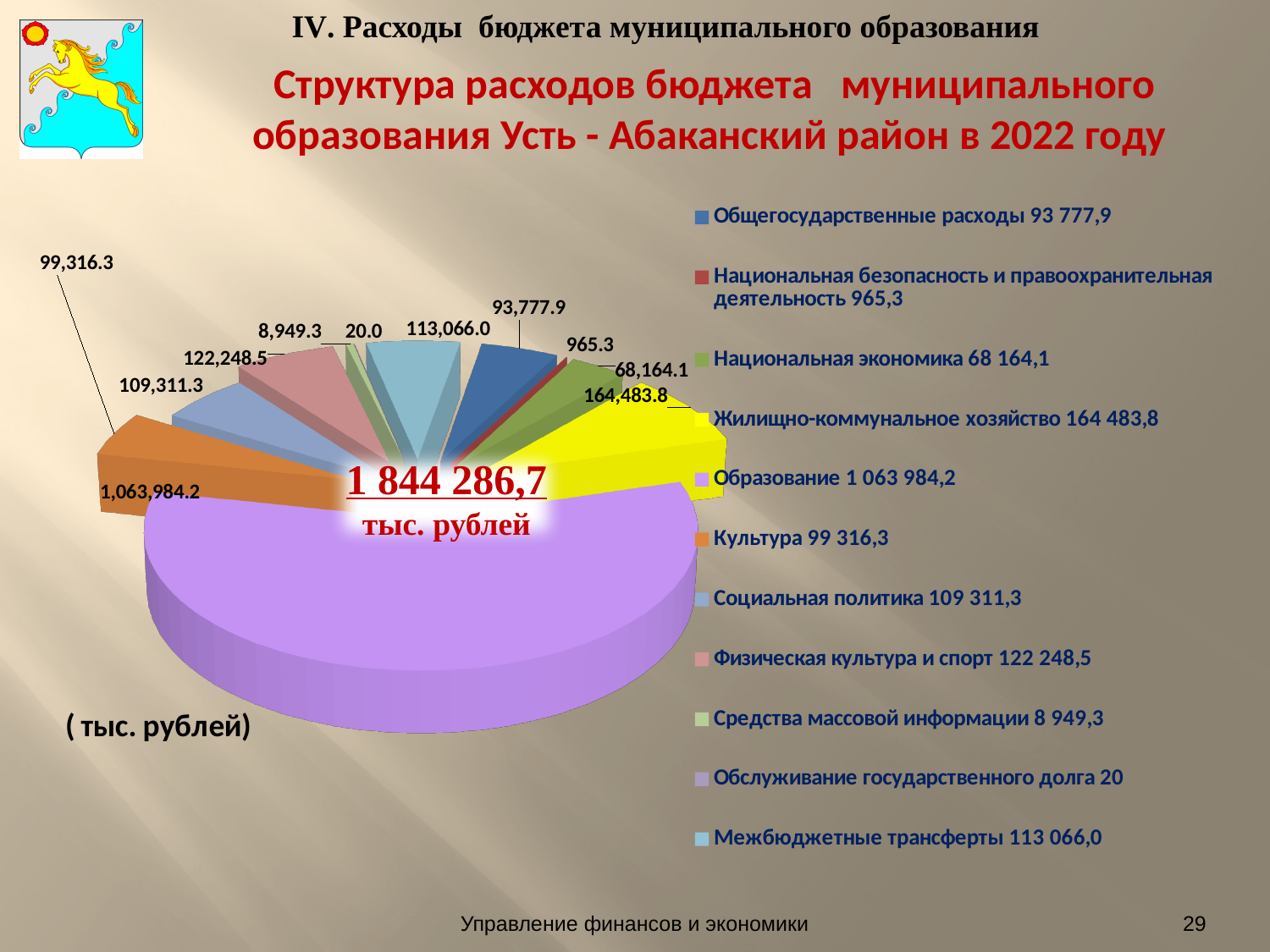
What unit is stated below the pie chart? тыс. рублей What is the value for Жилищно-коммунальное хозяйство? 164,483.8 What is the value for Межбюджетные трансферты? 113,066.0 Which is larger, Культура or Социальная политика? Социальная политика Which category has the largest slice of the pie chart? Образование Which category has the smallest slice of the pie chart? Обслуживание государственного долга How many categories does the pie chart have? 11 What total value is printed in the centre of the pie chart? 1 844 286,7 тыс. рублей What is the difference between Жилищно-коммунальное хозяйство and Межбюджетные трансферты? 51,417.8 What kind of chart is shown on the slide? Pie chart What is the value for Национальная безопасность и правоохранительная деятельность? 965.3 What is the value for Образование? 1,063,984.2